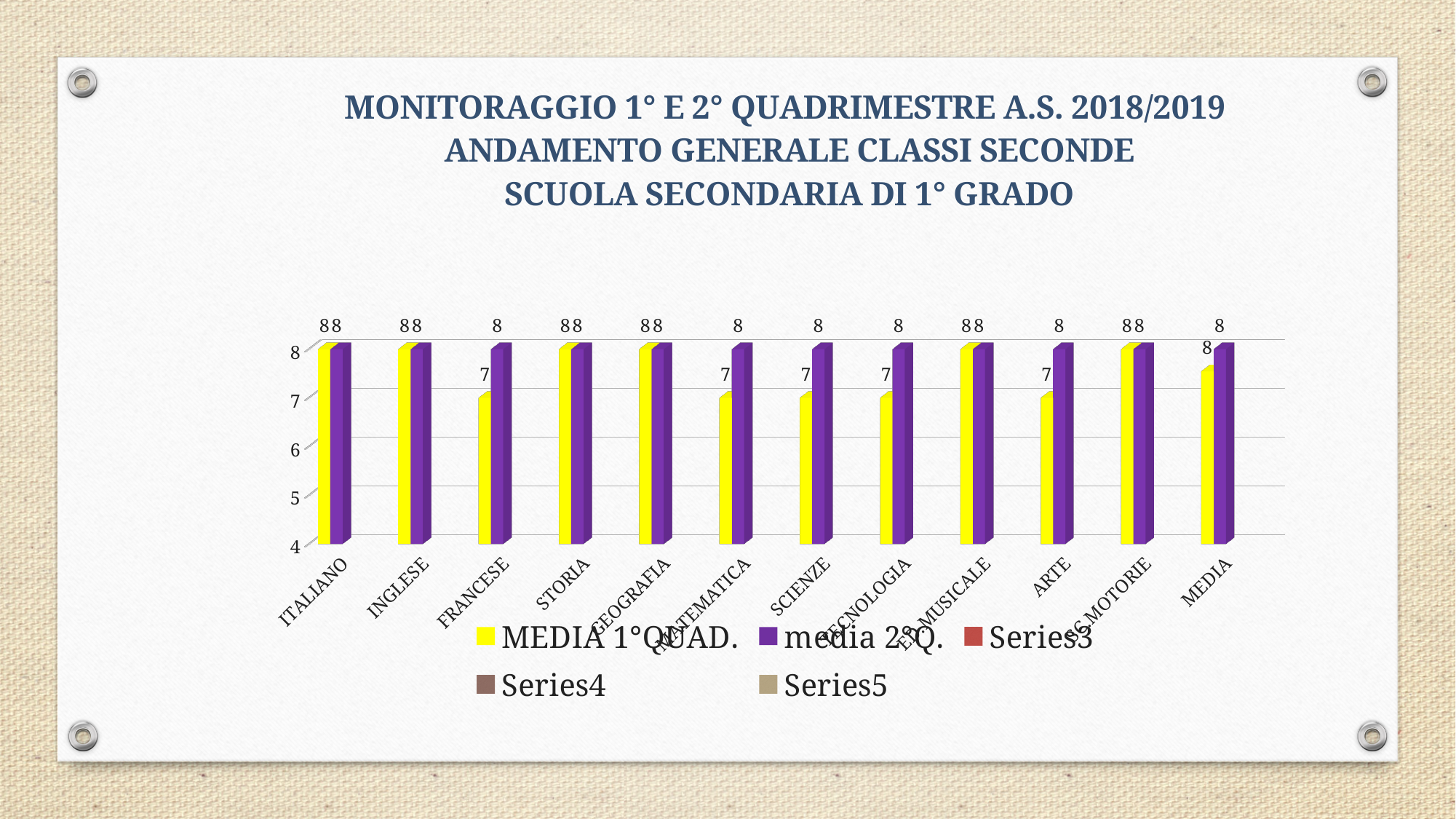
What is the MEDIA 1°QUAD. value for STORIA? 8 Is the MEDIA 1°QUAD. value for FRANCESE greater or less than 8? less What is the MEDIA 1°QUAD. value for FRANCESE? 7 What is the MEDIA 1°QUAD. value for ARTE? 7 For SCIENZE, what is the difference between the media 2°Q. value and the MEDIA 1°QUAD. value? 1 What is the media 2°Q. value for FRANCESE? 8 How many categories are shown on the x axis of the chart? 12 What colour represents the MEDIA 1°QUAD. series in the legend? yellow For ARTE, which series has the larger value, MEDIA 1°QUAD. or media 2°Q.? media 2°Q. How many series does the legend list? 5 What kind of chart is shown on the slide? bar chart What is the media 2°Q. value for ITALIANO? 8